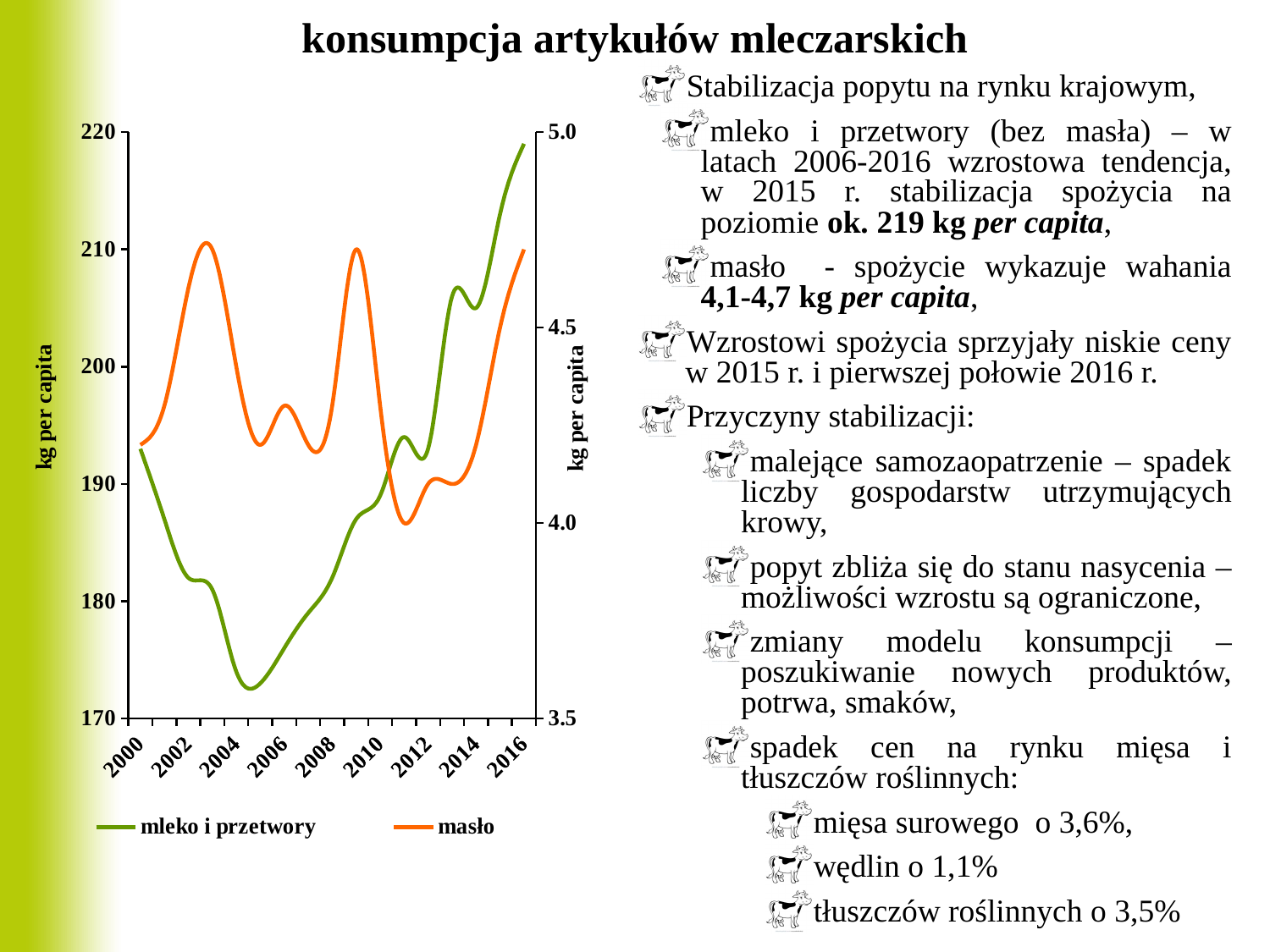
Which is larger for masło: the value in 2003 or the value in 2005? 2003 Is the value for masło in 2003 greater or less than 4.5? greater How many year labels are shown on the x axis of the chart? 9 What is the title of the slide containing the chart? konsumpcja artykułów mleczarskich What are the two series named in the chart legend? mleko i przetwory, masło In which year does the mleko i przetwory series reach its highest value? 2016 What kind of chart is shown on the slide? line chart How many series does the chart legend list? 2 Is the value for mleko i przetwory in 2005 greater or less than 180? less Is the value for mleko i przetwory in 2016 greater or less than 210? greater In which year does the mleko i przetwory series reach its lowest value? 2005 Does the mleko i przetwory series rise or fall between 2006 and 2016? rise